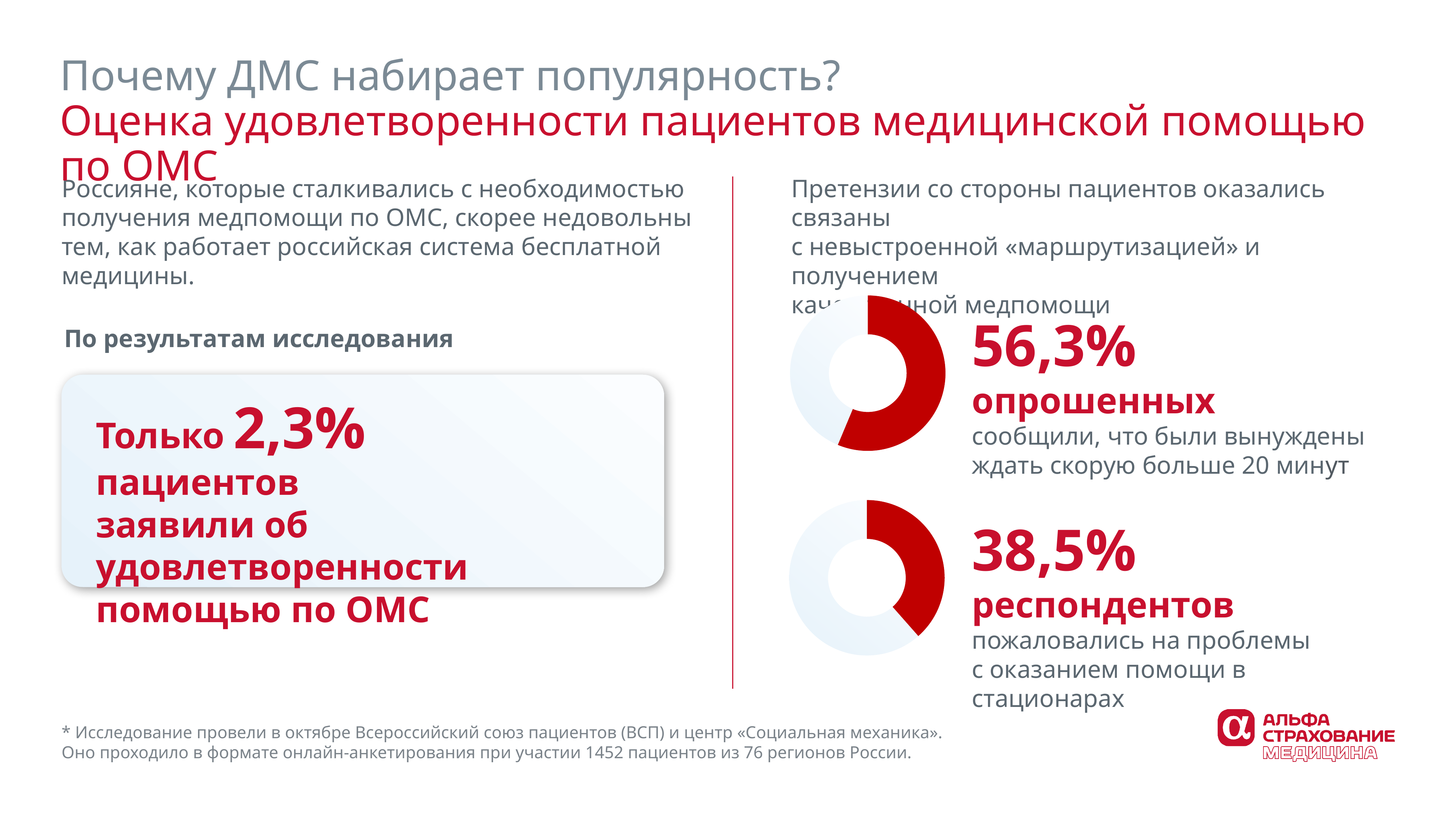
What colour is used for the highlighted segment in both donut charts? Red Which of the two donut charts has the smaller highlighted share? The lower one (38,5%) How many donut charts are shown on the slide? 2 In the upper donut chart, what share of respondents said they had to wait for an ambulance more than 20 minutes? 56,3% Is the highlighted share in the lower donut chart greater or less than 50%? less In the lower donut chart, what share of respondents complained about problems with care in hospitals (стационарах)? 38,5% According to the highlighted box on the left, what percentage of patients declared satisfaction with care under ОМС? 2,3% What kind of chart is used on the right side of the slide to show the 56,3% and 38,5% figures? Donut (pie) chart Is the highlighted share in the upper donut chart greater or less than 50%? greater What is the difference in percentage points between the upper donut chart value (56,3%) and the lower donut chart value (38,5%)? 17,8 percentage points How many segments does each donut chart have? 2 Which donut chart shows the larger highlighted share: the upper one (waiting for an ambulance) or the lower one (hospital care problems)? The upper one (56,3%)